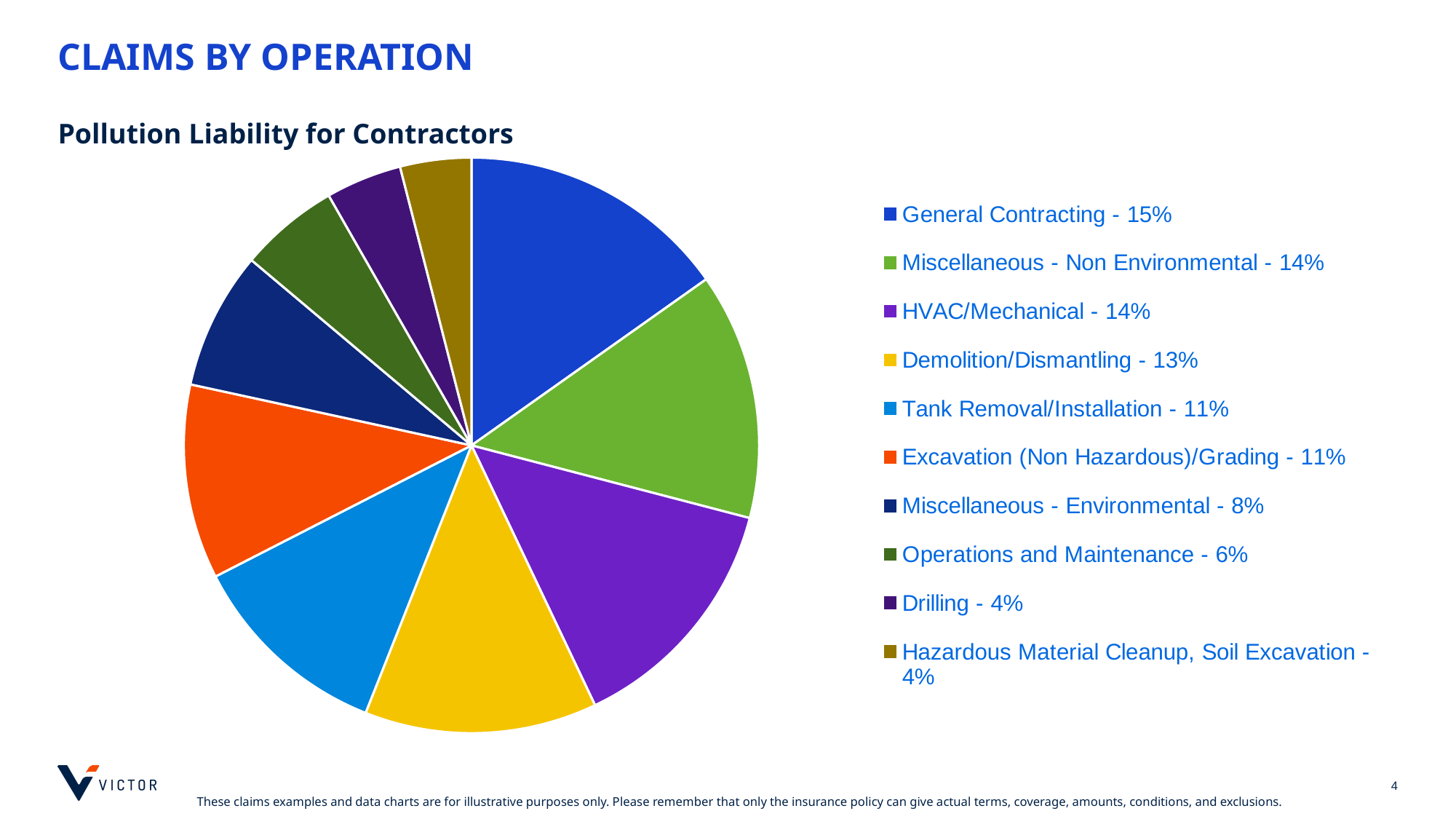
What is the subtitle shown above the pie chart? Pollution Liability for Contractors What percentage of claims is for Demolition/Dismantling? 13% Which has a larger share of claims, Demolition/Dismantling or Tank Removal/Installation? Demolition/Dismantling What percentage of claims is for Tank Removal/Installation? 11% What percentage of claims is for Miscellaneous - Environmental? 8% How many operation categories are shown in the pie chart? 10 What percentage of claims is for Operations and Maintenance? 6% What share of claims is attributed to General Contracting? 15% Which operation accounts for the largest share of claims? General Contracting What type of chart is shown on the slide? Pie chart What is the combined share of Drilling and Hazardous Material Cleanup, Soil Excavation? 8% What is the difference in percentage points between General Contracting and Operations and Maintenance? 9 percentage points